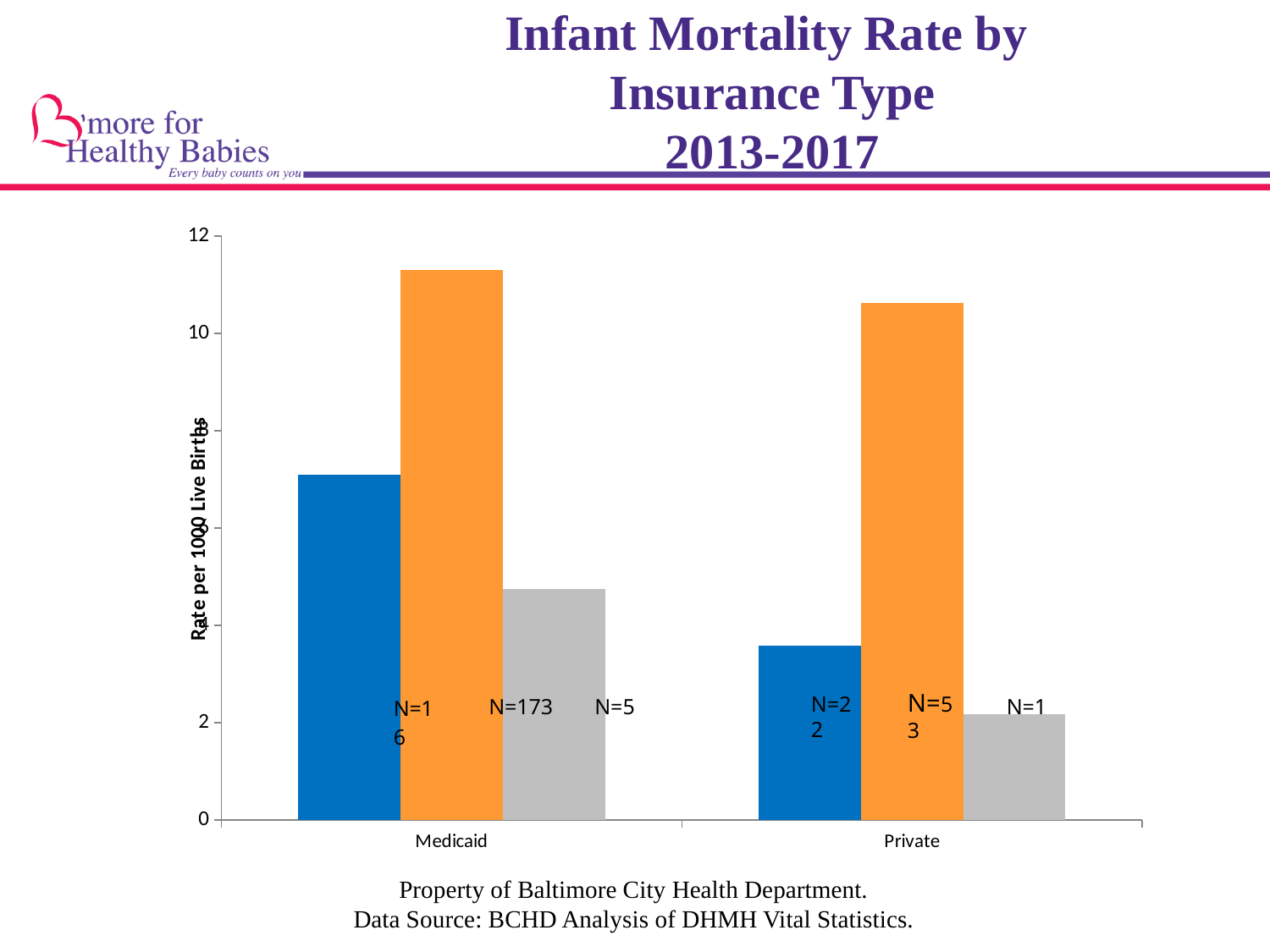
Is the value of the gray bar for Medicaid greater or less than 4? greater Is the value of the blue bar for Medicaid greater or less than 6? greater Which bar is the tallest in the chart? the orange bar for Medicaid What N value is printed for the orange bar in the Medicaid category? N=173 Is the value of the orange bar for Medicaid greater or less than 10? greater Which is larger, the blue bar for Medicaid or the blue bar for Private? the blue bar for Medicaid How many bars are plotted for the Medicaid category? 3 How many insurance type categories are shown on the x axis? 2 What is the label on the y axis? Rate per 1000 Live Births What kind of chart is shown on the slide? bar chart